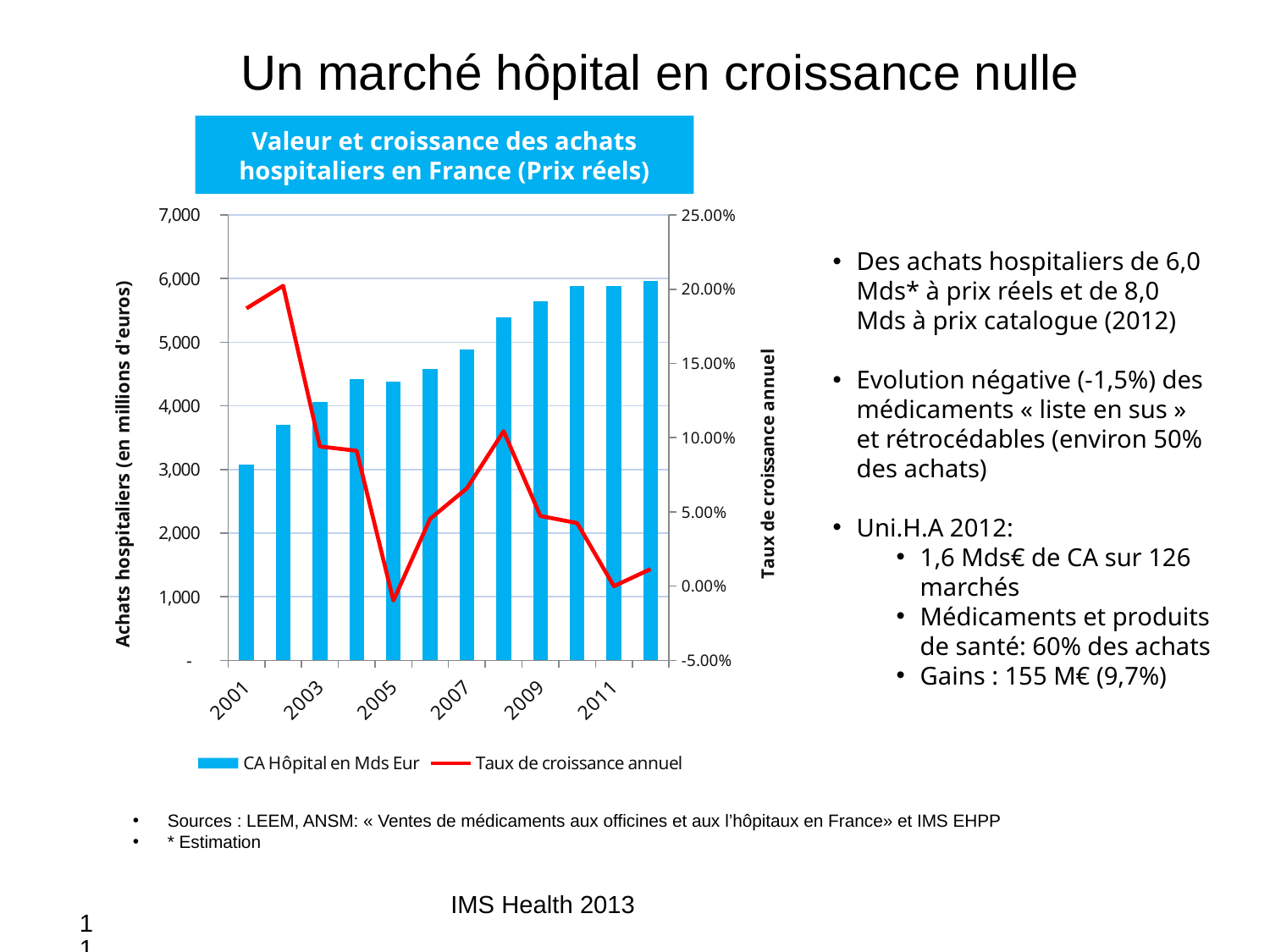
How many series does the chart legend list? 2 What kind of chart is shown on the slide? A combined bar and line chart How many bars (years) are plotted in the chart? 12 Do the CA Hôpital bars generally rise or fall from 2001 to 2012? rise What are the two series named in the chart legend? CA Hôpital en Mds Eur and Taux de croissance annuel Is the CA Hôpital bar for 2005 greater or less than 4,000? greater In which year does the Taux de croissance annuel line reach its lowest point? 2005 Is the Taux de croissance annuel for 2005 greater or less than 0.00%? less In which year does the Taux de croissance annuel line reach its highest point? 2002 Is the CA Hôpital bar for 2002 greater or less than 4,000? less Which year has the lowest bar for CA Hôpital en Mds Eur? 2001